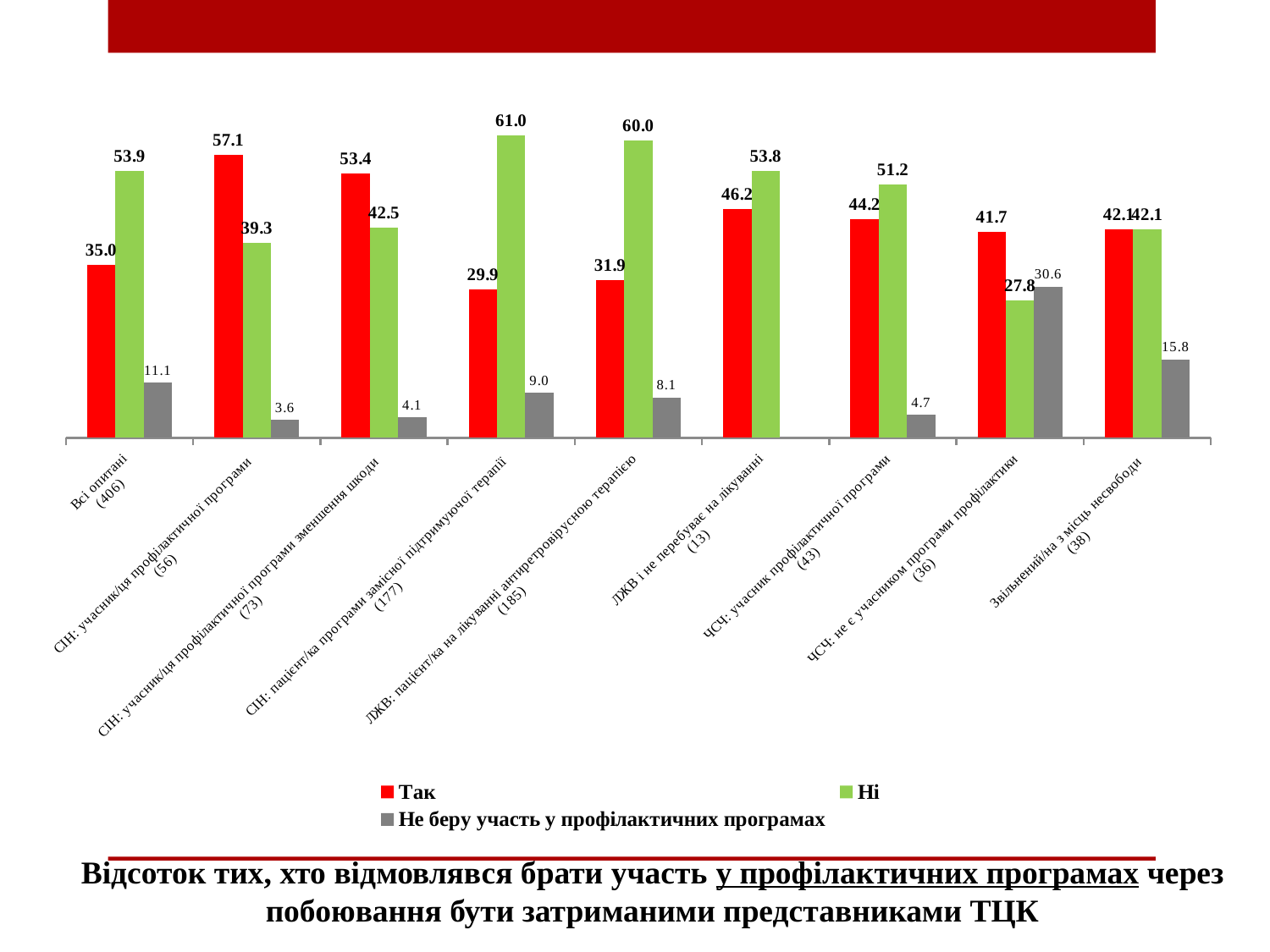
What is the value of the "Не беру участь у профілактичних програмах" series for "ЧСЧ: не є учасником програми профілактики (36)"? 30.6 Which category has the highest value in the "Так" series? СІН: учасник/ця профілактичної програми (56) What is the difference between the "Ні" and "Так" values for "Всі опитані (406)"? 18.9 What is the value of the "Так" series for "Всі опитані (406)"? 35.0 What is the value of the "Ні" series for "СІН: пацієнт/ка програми замісної підтримуючої терапії (177)"? 61.0 Which colour represents the "Ні" series in the legend? Green How many categories are shown on the x axis? 9 How many series does the legend list? 3 Which category has the lowest value in the "Не беру участь у профілактичних програмах" series among those with a grey bar? СІН: учасник/ця профілактичної програми (56) What is the value of the "Так" series for "Звільнений/на з місць несвободи (38)"? 42.1 For "ЧСЧ: не є учасником програми профілактики (36)", which is larger: the "Так" value or the "Ні" value? Так What kind of chart is shown on the slide? Bar chart